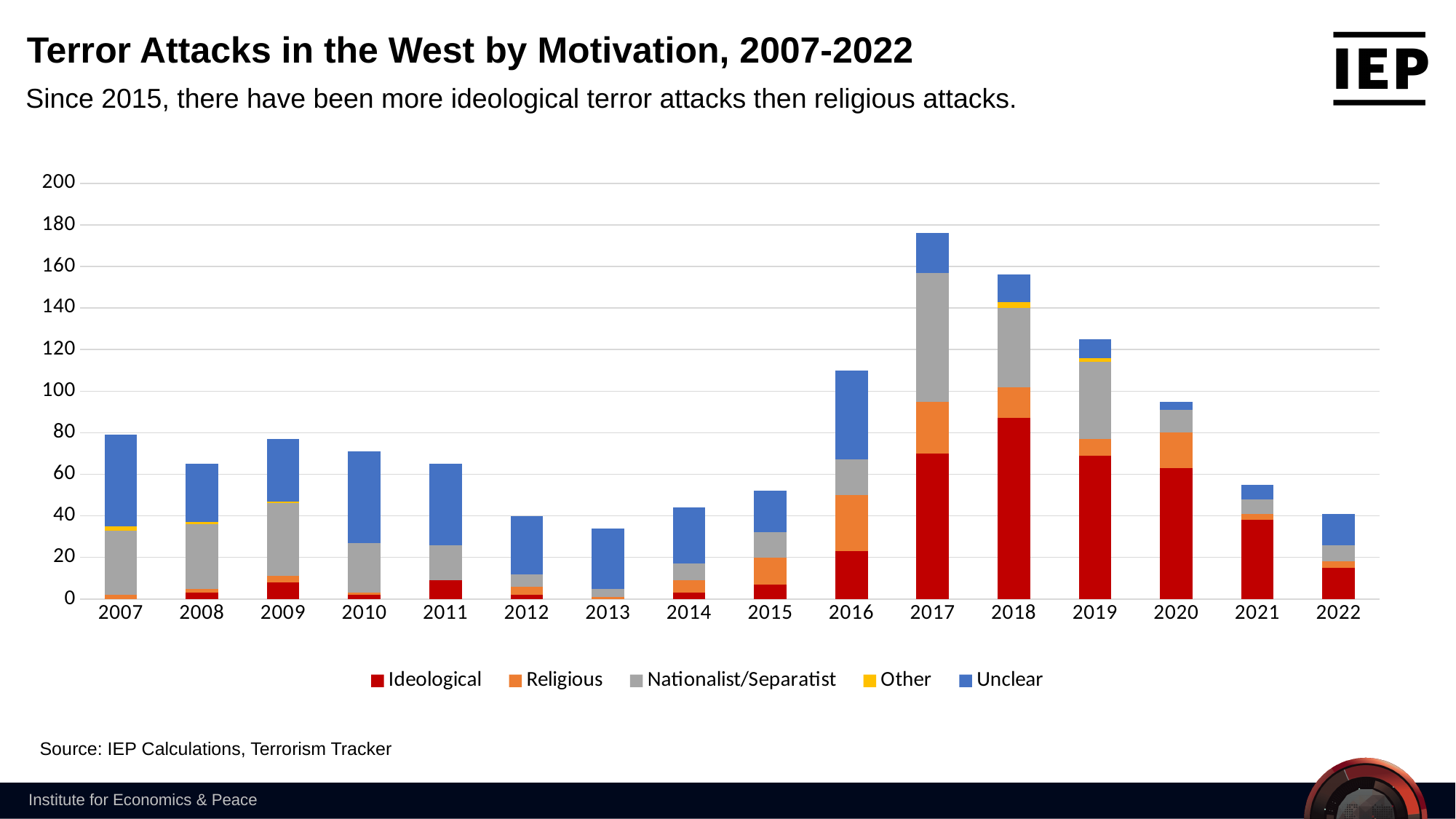
Do the total attacks rise or fall from 2017 to 2022? fall What kind of chart is shown on the slide? stacked bar chart Which year has a larger total of terror attacks, 2020 or 2021? 2020 How many series does the legend list? 5 Which year has the highest total number of terror attacks? 2017 Which year has the lowest total number of terror attacks? 2013 Which series is shown in red in the legend? Ideological Is the total for 2017 greater or less than 160? greater How many years are shown along the x axis of the chart? 16 Is the total for 2013 greater or less than 40? less Is the total for 2016 greater or less than 100? greater Which year has a larger total of terror attacks, 2018 or 2019? 2018